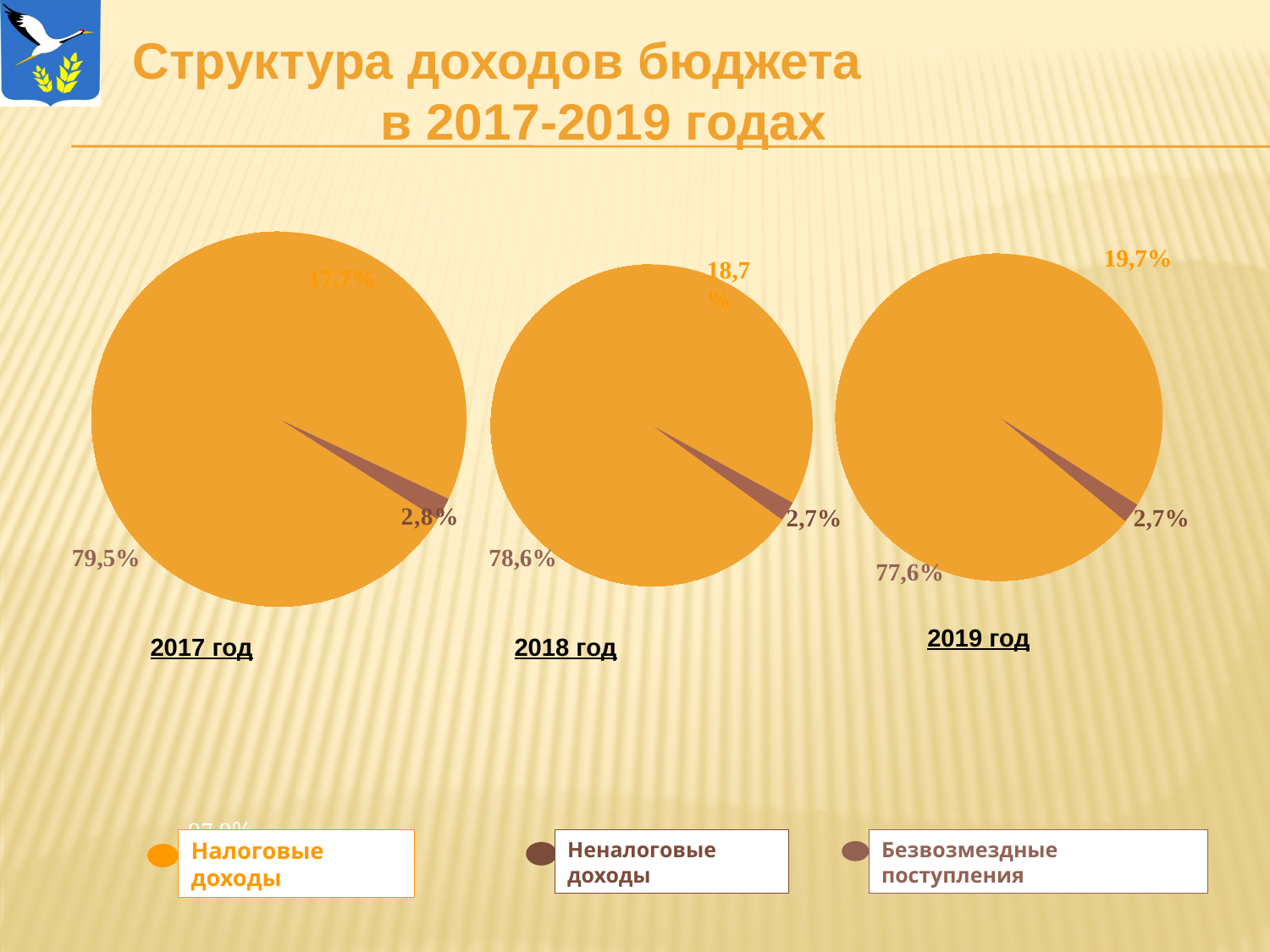
What kind of charts are shown on the slide? Pie charts In the 2018 год pie chart, what value is labelled at the top right of the pie? 18,7% How many entries does the legend list? 3 Which year's pie chart has the largest value for its biggest slice: 2017, 2018 or 2019? 2017 год In the 2019 год pie chart, what is the value of the smallest (brown) slice? 2,7% What is the difference between the largest slice in 2017 год (79,5%) and the largest slice in 2019 год (77,6%)? 1,9% Does the value of the largest slice rise or fall from 2017 to 2019? Fall How many pie charts are on the slide? 3 In the 2017 год pie chart, what is the value of the smallest (brown) slice? 2,8% In the 2018 год pie chart, what is the value of the largest slice? 78,6% In the 2019 год pie chart, what is the value of the largest slice? 77,6% In the 2017 год pie chart, what is the value of the largest slice? 79,5%